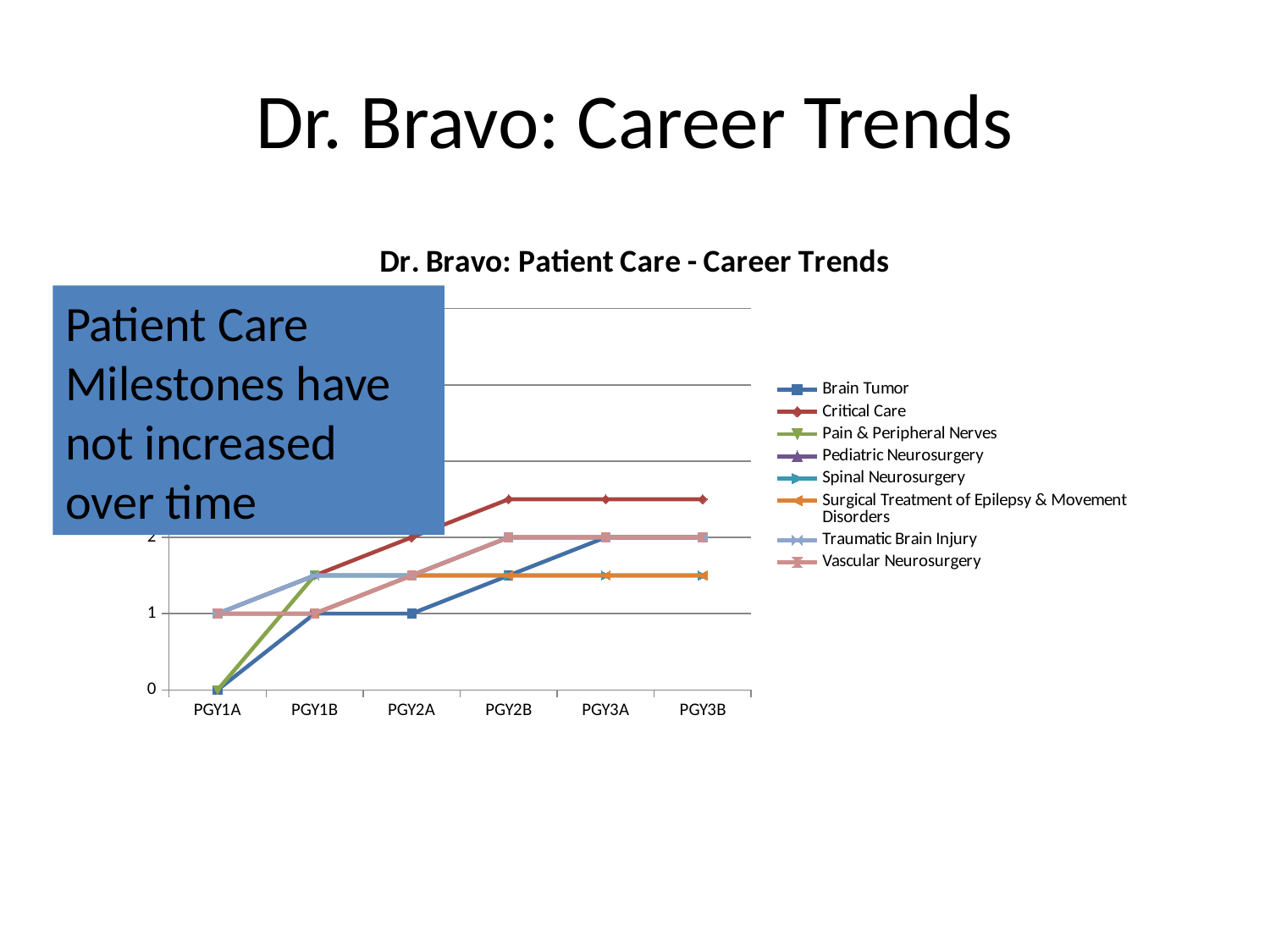
What is the value for Brain Tumor at PGY1A? 0 What is the value for Critical Care at PGY1A? 1 At PGY2A, which is larger: Critical Care or Brain Tumor? Critical Care Is the value for Brain Tumor at PGY2B greater or less than 2? less What is the value for Critical Care at PGY2A? 2 Which series has the highest value at PGY3B? Critical Care What is the value for Brain Tumor at PGY3B? 2 How many categories are shown on the x axis of the chart? 6 Is the value for Critical Care at PGY3B greater or less than 2? greater What kind of chart is shown on the slide? line chart Does the Brain Tumor series rise or fall from PGY1A to PGY3B? rise How many series does the chart's legend list? 8